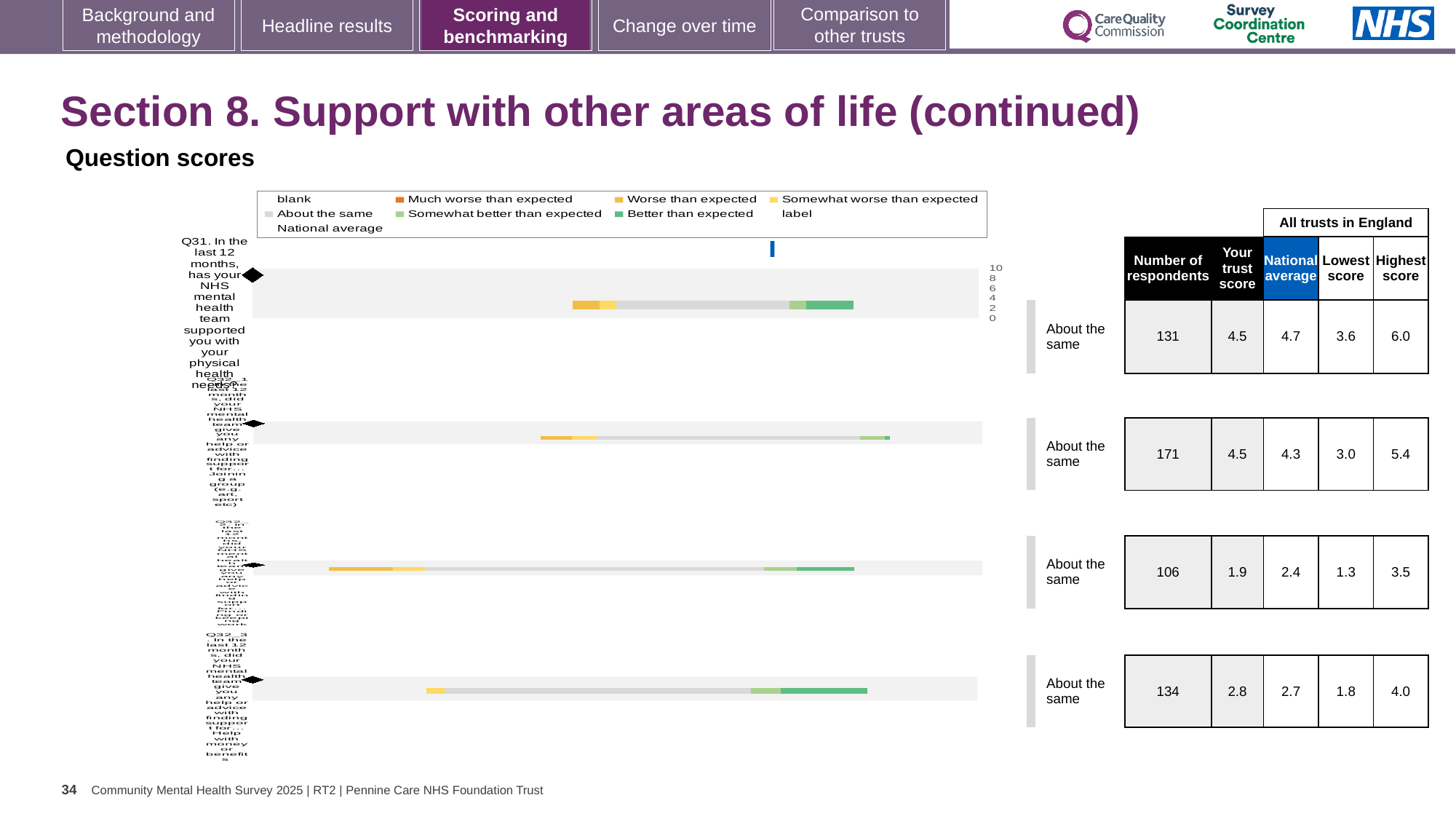
In the table beside the chart, what is 'Your trust score' for the first row (Q31)? 4.5 What kind of chart is shown on the slide? bar chart How many entries does the chart legend list? 9 In the table beside the chart, which row has the highest number of respondents? the second row (171) What colour represents 'Better than expected' in the chart legend? green How many question bars are plotted in the chart? 4 In the table beside the chart, what is the number of respondents for the first row (Q31)? 131 What benchmark category is shown next to every bar in the chart? About the same In the table beside the chart, what is the highest score for the first row (Q31)? 6.0 In the table beside the chart, for the first row (Q31), which is larger: 'Your trust score' or the national average? National average In the table beside the chart, what is the difference between the highest score and the lowest score for the first row (Q31)? 2.4 In the table beside the chart, what is the national average for the first row (Q31)? 4.7